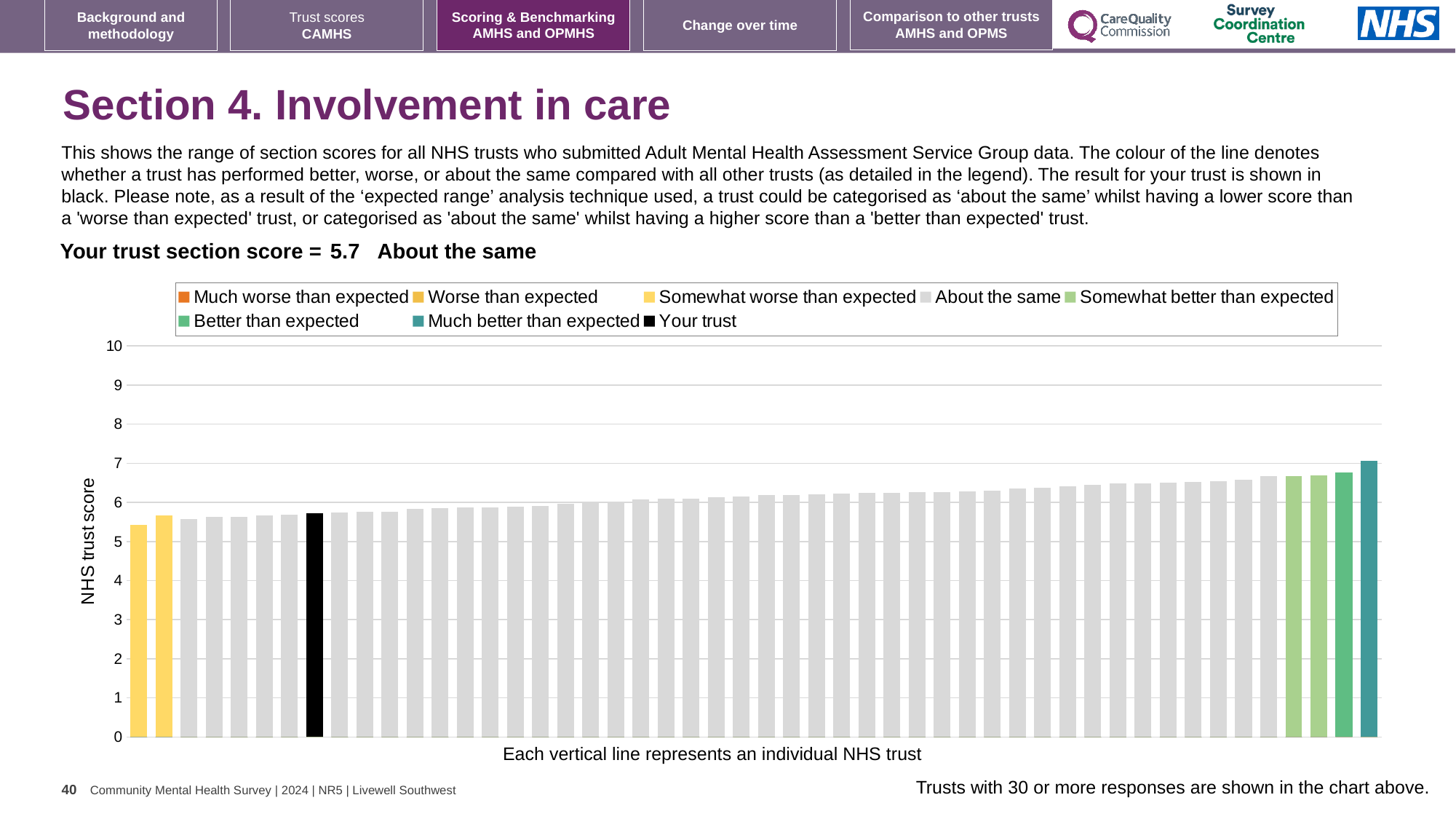
Which legend category does the shortest bar belong to? Somewhat worse than expected What is the label on the y axis of the chart? NHS trust score What is the section score for your trust? 5.7 Do the bar values rise or fall from left to right along the x axis? rise Which legend category does the tallest bar belong to? Much better than expected Is the value of the tallest bar greater or less than 6? greater Is the value of the shortest bar greater or less than 6? less How many entries does the chart legend list? 8 Which category is your trust placed in for this section? About the same What kind of chart is shown on the slide? bar chart Is the value of the black 'Your trust' bar greater or less than 5? greater